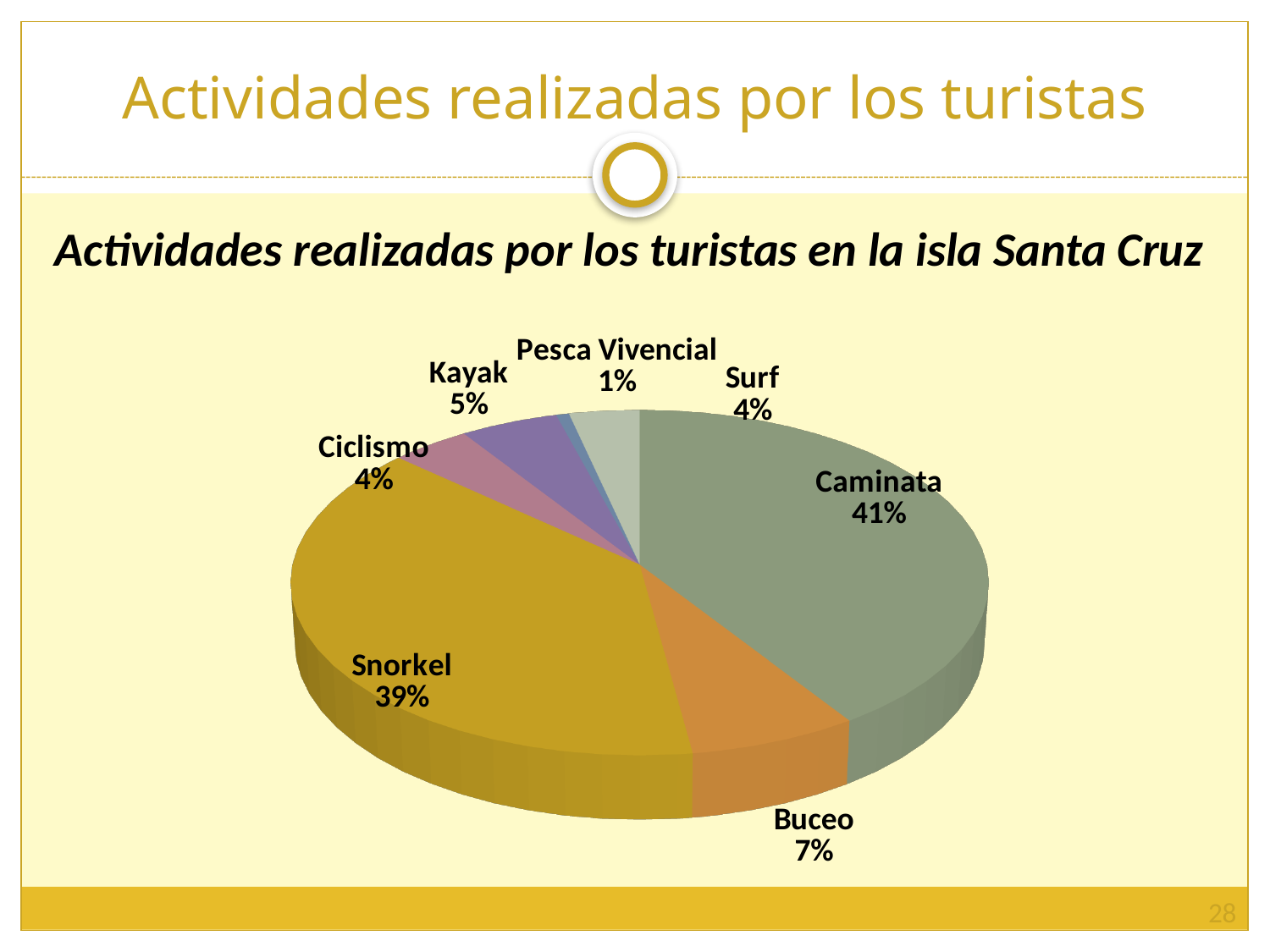
What is the value shown for Kayak? 5% What kind of chart is shown on the slide? pie chart How many activities (slices) are shown in the pie chart? 7 What is the value shown for Snorkel? 39% What is the value shown for Buceo? 7% What percentage of tourists did Caminata? 41% Which activity has the largest share of the pie? Caminata What is the value shown for Pesca Vivencial? 1% What is the title of the chart? Actividades realizadas por los turistas en la isla Santa Cruz What is the difference in percentage points between Caminata and Snorkel? 2 Which activity has the smallest share of the pie? Pesca Vivencial Which is larger, the share for Buceo or the share for Kayak? Buceo